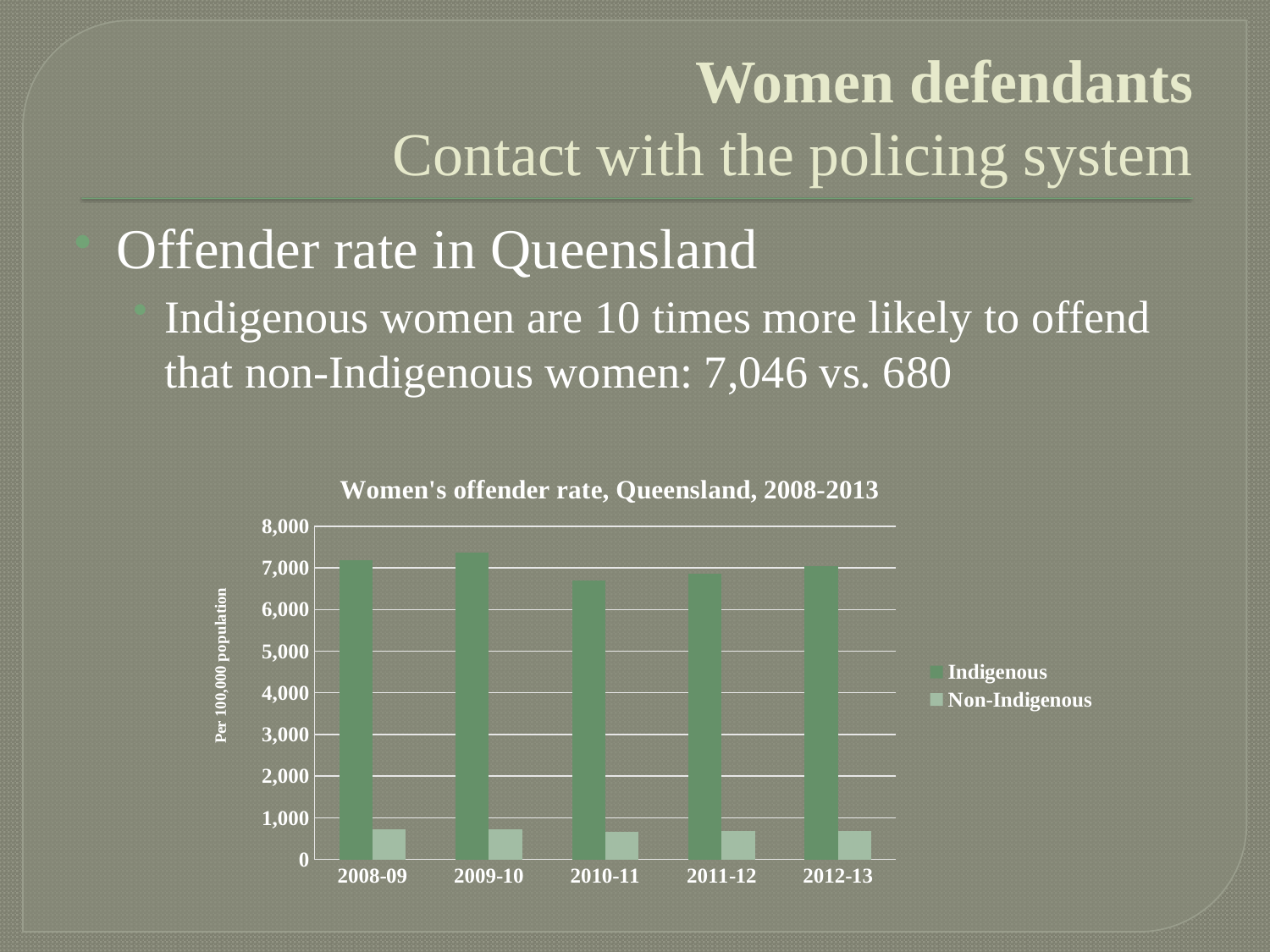
What kind of chart is shown on the slide? Bar chart What is the label on the vertical axis of the chart? Per 100,000 population How many year categories are shown on the x axis of the chart? 5 Is the Indigenous value for 2009-10 greater or less than 7,000? greater Is the Non-Indigenous value for 2008-09 greater or less than 1,000? less In which year is the Indigenous women's offender rate highest? 2009-10 In 2012-13, which series has the larger value, Indigenous or Non-Indigenous? Indigenous Is the Indigenous value for 2011-12 greater or less than 7,000? less How many series does the chart legend list? 2 What is the title of the chart? Women's offender rate, Queensland, 2008-2013